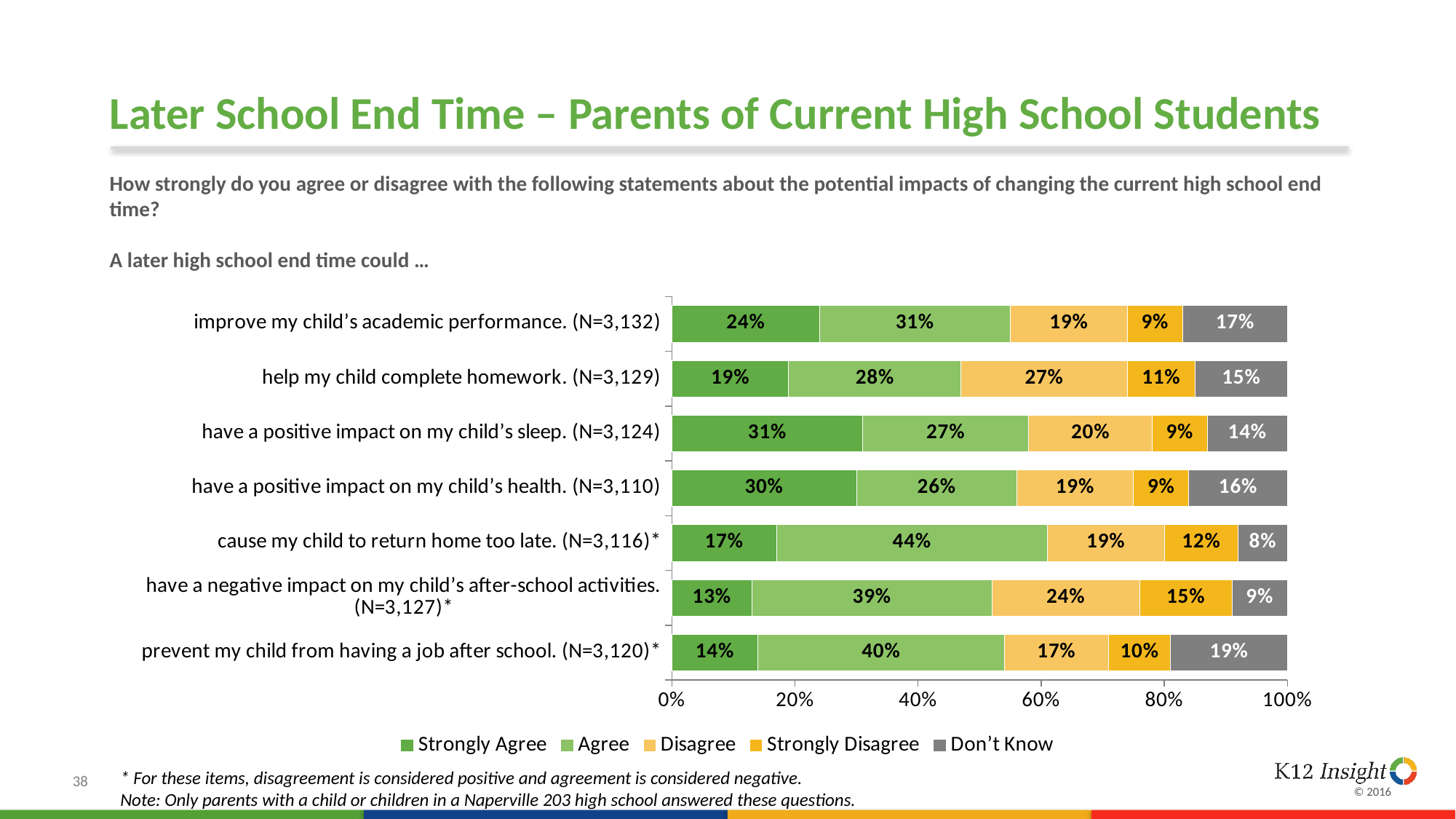
What is the sample size (N) for the statement 'have a positive impact on my child's health'? 3,110 Which statement has the highest Strongly Agree percentage? have a positive impact on my child's sleep What is the difference between the Disagree percentage for 'help my child complete homework' and the Disagree percentage for 'improve my child's academic performance'? 8% Which is larger: the Strongly Disagree percentage for 'have a negative impact on my child's after-school activities' or for 'cause my child to return home too late'? have a negative impact on my child's after-school activities Which statement has the lowest Don't Know percentage? cause my child to return home too late What percentage of parents strongly agree that a later high school end time could have a positive impact on my child's sleep? 31% How many response categories does the legend list? 5 What percentage of parents agree that a later end time could cause my child to return home too late? 44% What is the Don't Know percentage for the statement 'prevent my child from having a job after school'? 19% What type of chart is shown on the slide? Stacked bar chart How many statements are shown in the chart? 7 What is the total of the stacked bar for 'improve my child's academic performance'? 100%